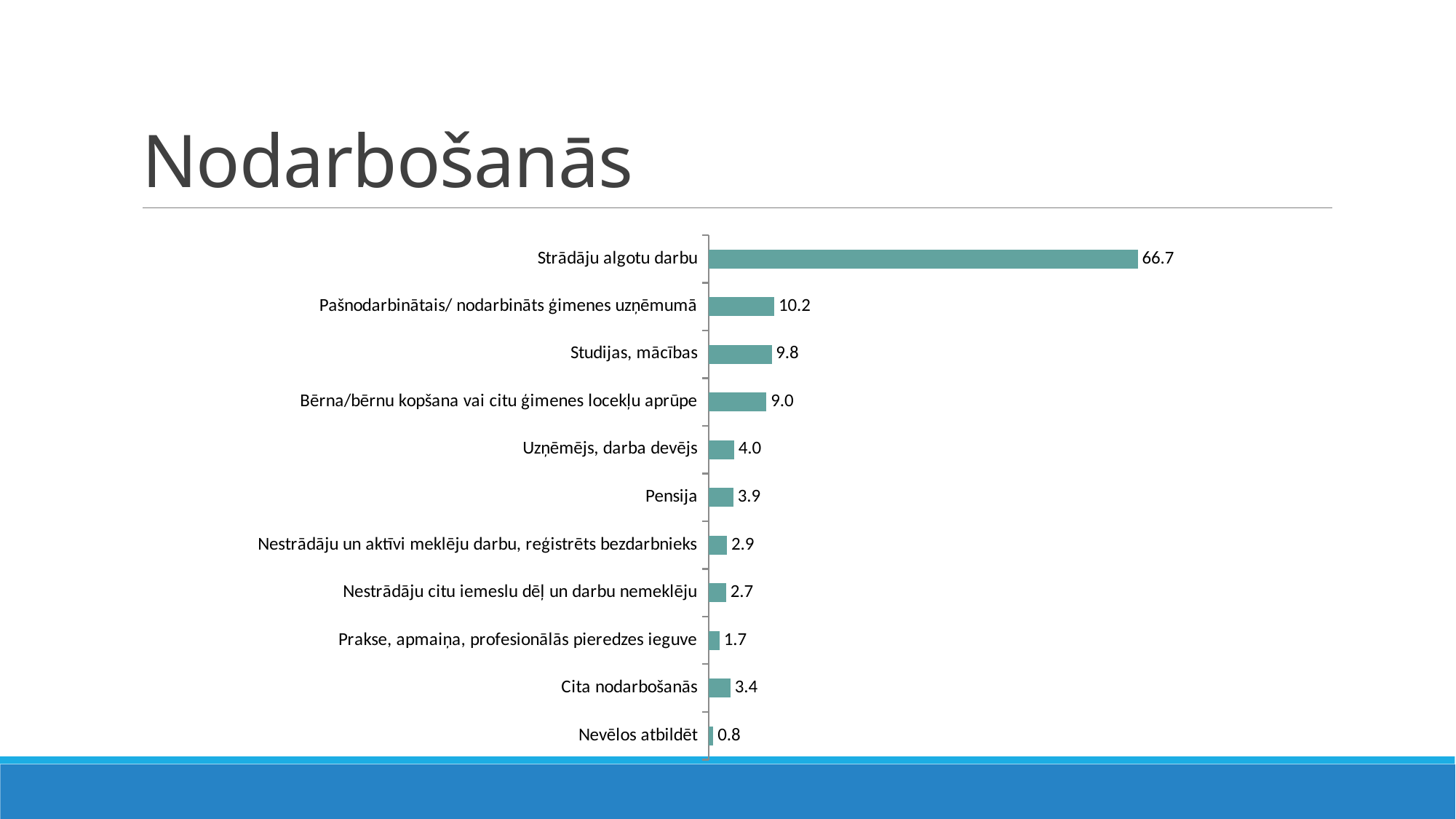
What is the difference between the values for "Pašnodarbinātais/ nodarbināts ģimenes uzņēmumā" and "Studijas, mācības"? 0.4 What is the value for "Strādāju algotu darbu"? 66.7 What is the value for "Pensija"? 3.9 Which is larger: the value for "Cita nodarbošanās" or the value for "Prakse, apmaiņa, profesionālās pieredzes ieguve"? Cita nodarbošanās What is the title of the slide? Nodarbošanās What is the value for "Studijas, mācības"? 9.8 What is the value for "Cita nodarbošanās"? 3.4 What is the difference between the values for "Strādāju algotu darbu" and "Bērna/bērnu kopšana vai citu ģimenes locekļu aprūpe"? 57.7 What kind of chart is shown on the slide? Bar chart How many categories are shown in the chart? 11 Which category has the lowest value? Nevēlos atbildēt Which category has the highest value? Strādāju algotu darbu